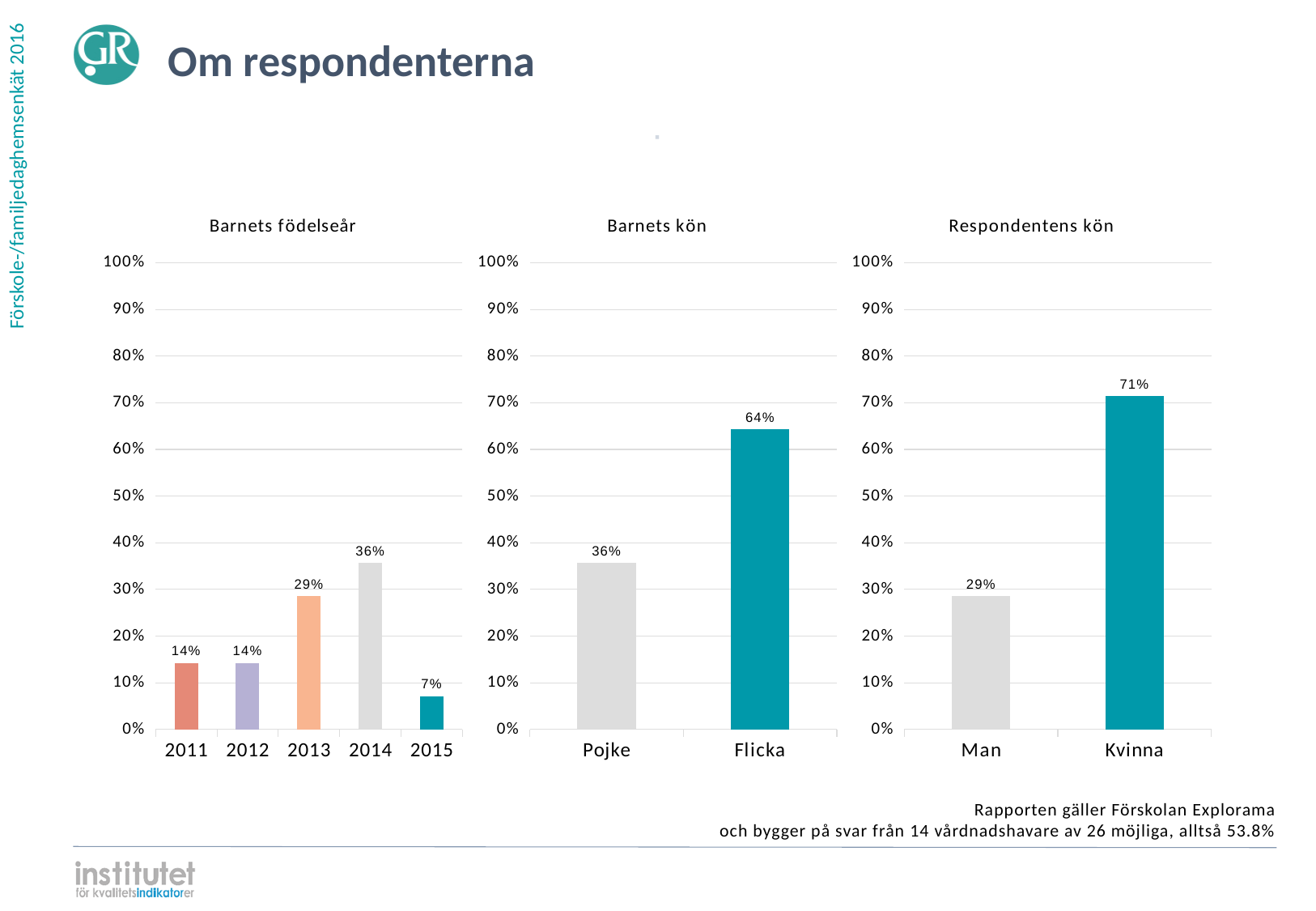
In the 'Barnets födelseår' chart, which year has the lowest value? 2015 In the 'Respondentens kön' chart, is the value for Kvinna greater or less than 70%? greater In the 'Barnets födelseår' chart, what is the difference between the values for 2013 and 2015? 22% How many charts are shown on the slide? 3 What kind of chart is the 'Respondentens kön' chart? Bar chart In the 'Barnets födelseår' chart, how many years are shown on the x axis? 5 In the 'Respondentens kön' chart, what is the value for Man? 29% In the 'Barnets kön' chart, which category is larger, Pojke or Flicka? Flicka In the 'Barnets kön' chart, what is the value for Flicka? 64% In the 'Barnets födelseår' chart, what is the value for 2014? 36% In the 'Barnets kön' chart, what is the difference between Flicka and Pojke? 28% In the 'Barnets födelseår' chart, which year has the highest value? 2014